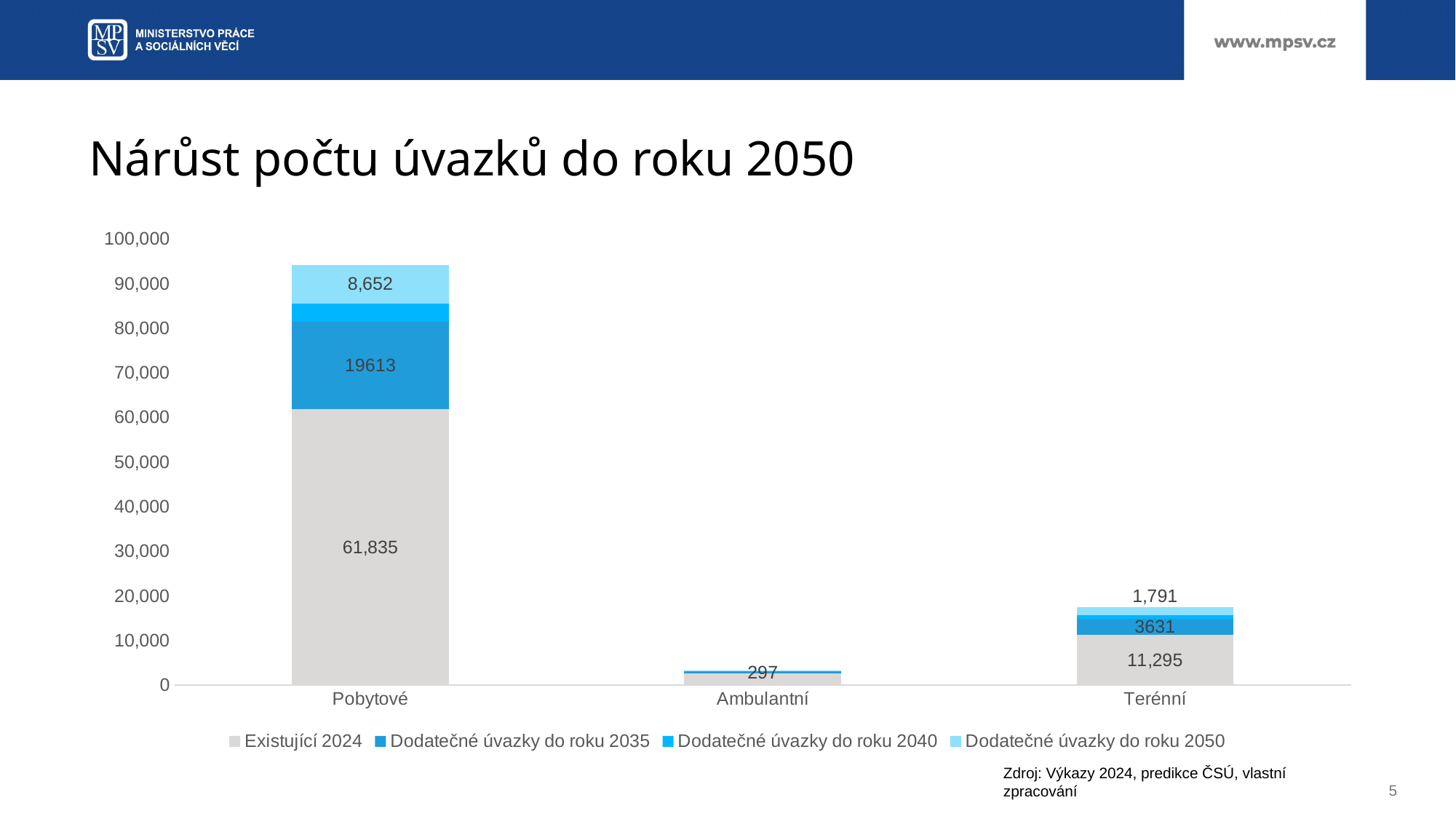
What is the value of Existující 2024 for Pobytové? 61,835 Is the total height of the Pobytové bar greater or less than 90,000? greater How many categories are shown on the x axis of the chart? 3 Which category has the tallest stacked bar? Pobytové How many series does the chart legend list? 4 What is the value of Dodatečné úvazky do roku 2035 for Pobytové? 19613 What is the value of Dodatečné úvazky do roku 2050 for Terénní? 1,791 What is the difference between the Existující 2024 values for Pobytové and Terénní? 50,540 Which category has the shortest stacked bar? Ambulantní What is the value of Existující 2024 for Terénní? 11,295 What is the value of Dodatečné úvazky do roku 2050 for Pobytové? 8,652 What kind of chart is shown on the slide? bar chart